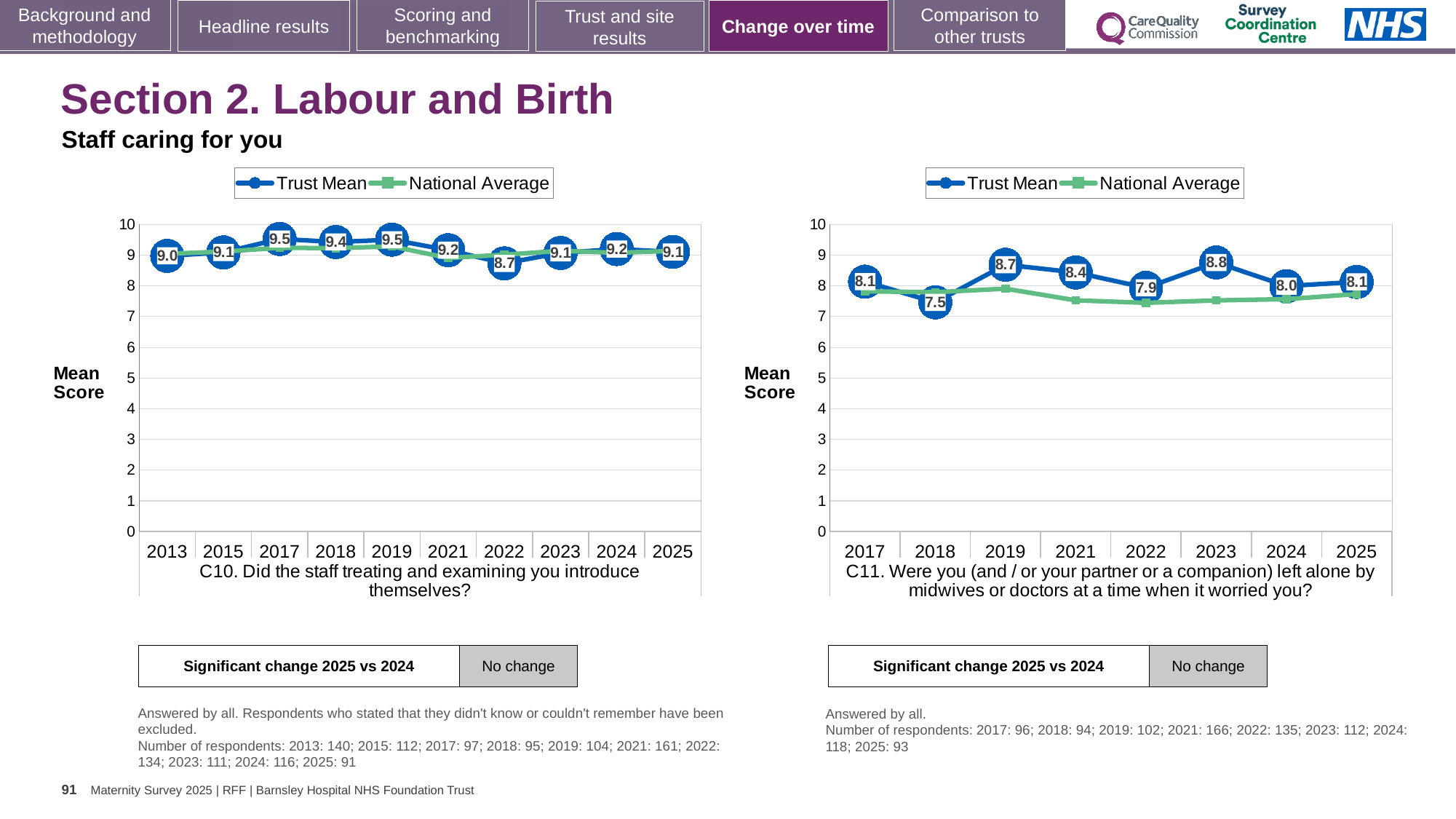
In the C11 chart on the right, what is the Trust Mean score for 2025? 8.1 How many series does the legend of the C11 chart on the right list? 2 In the C10 chart on the left, what is the difference between the Trust Mean scores for 2017 and 2022? 0.8 In the C11 chart on the right, is the National Average value for 2022 greater or less than 8? less In the C11 chart on the right, which year has the lowest Trust Mean score? 2018 How many years are shown on the x axis of the C10 chart on the left? 10 In the C10 chart on the left, what is the Trust Mean score for 2022? 8.7 What type of chart is the C10 chart on the left? Line chart In the C11 chart on the right, is the Trust Mean score for 2019 or 2022 higher? 2019 In the C11 chart on the right, what is the Trust Mean score for 2018? 7.5 In the C11 chart on the right, which year has the highest Trust Mean score? 2023 In the C10 chart on the left, which year has the lowest Trust Mean score? 2022